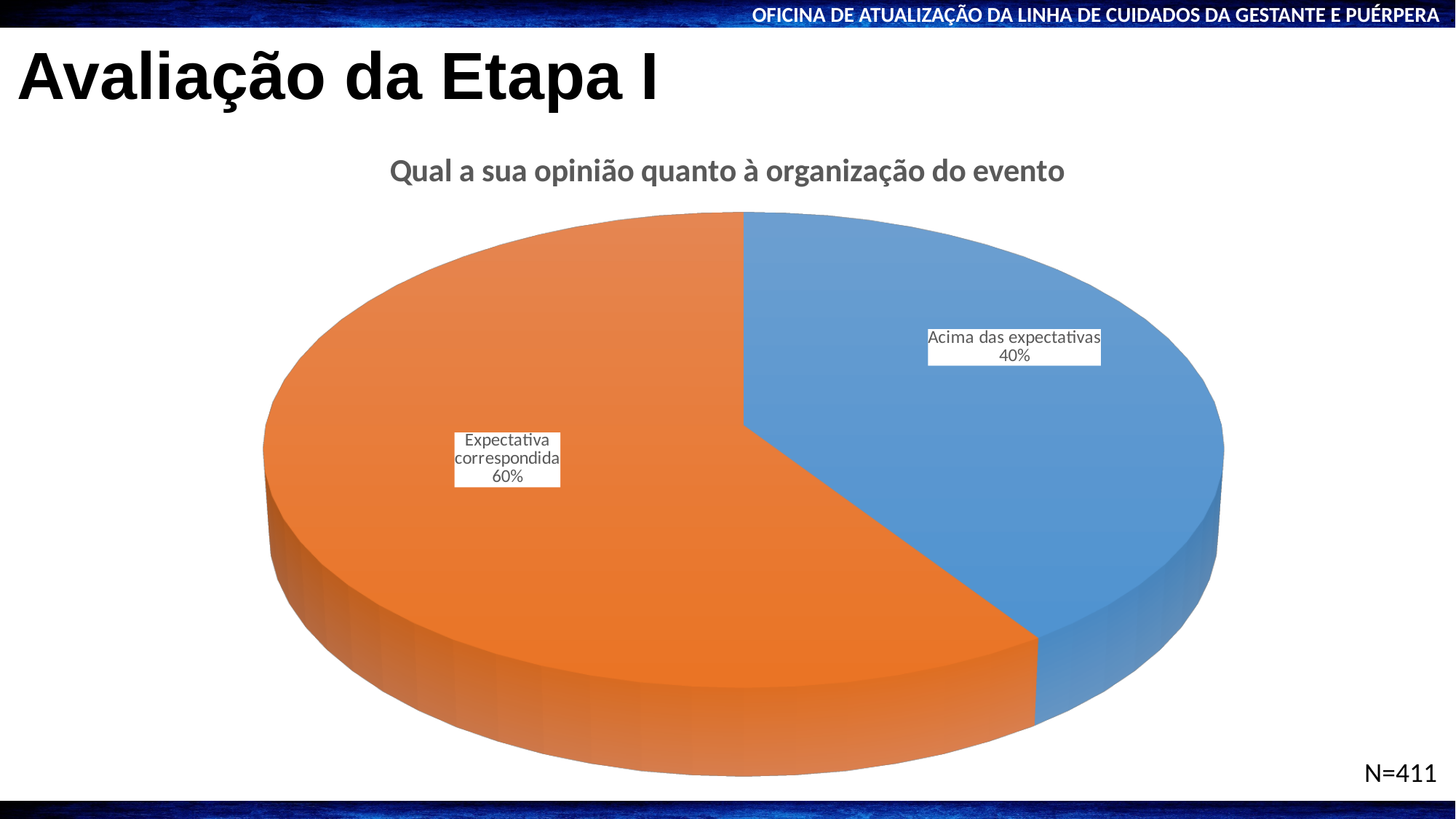
What is the difference in percentage points between "Expectativa correspondida" and "Acima das expectativas"? 20 percentage points What is the sample size (N) shown on the slide? 411 What colour is the "Acima das expectativas" slice? Blue What type of chart is shown on the slide? Pie chart What is the title of the chart? Qual a sua opinião quanto à organização do evento Which slice of the pie is the smallest? Acima das expectativas What share of the pie is labelled "Acima das expectativas"? 40% How many slices does the pie chart have? 2 What share of the pie is labelled "Expectativa correspondida"? 60% Which slice of the pie is the largest? Expectativa correspondida Which is larger: the share for "Acima das expectativas" or the share for "Expectativa correspondida"? Expectativa correspondida